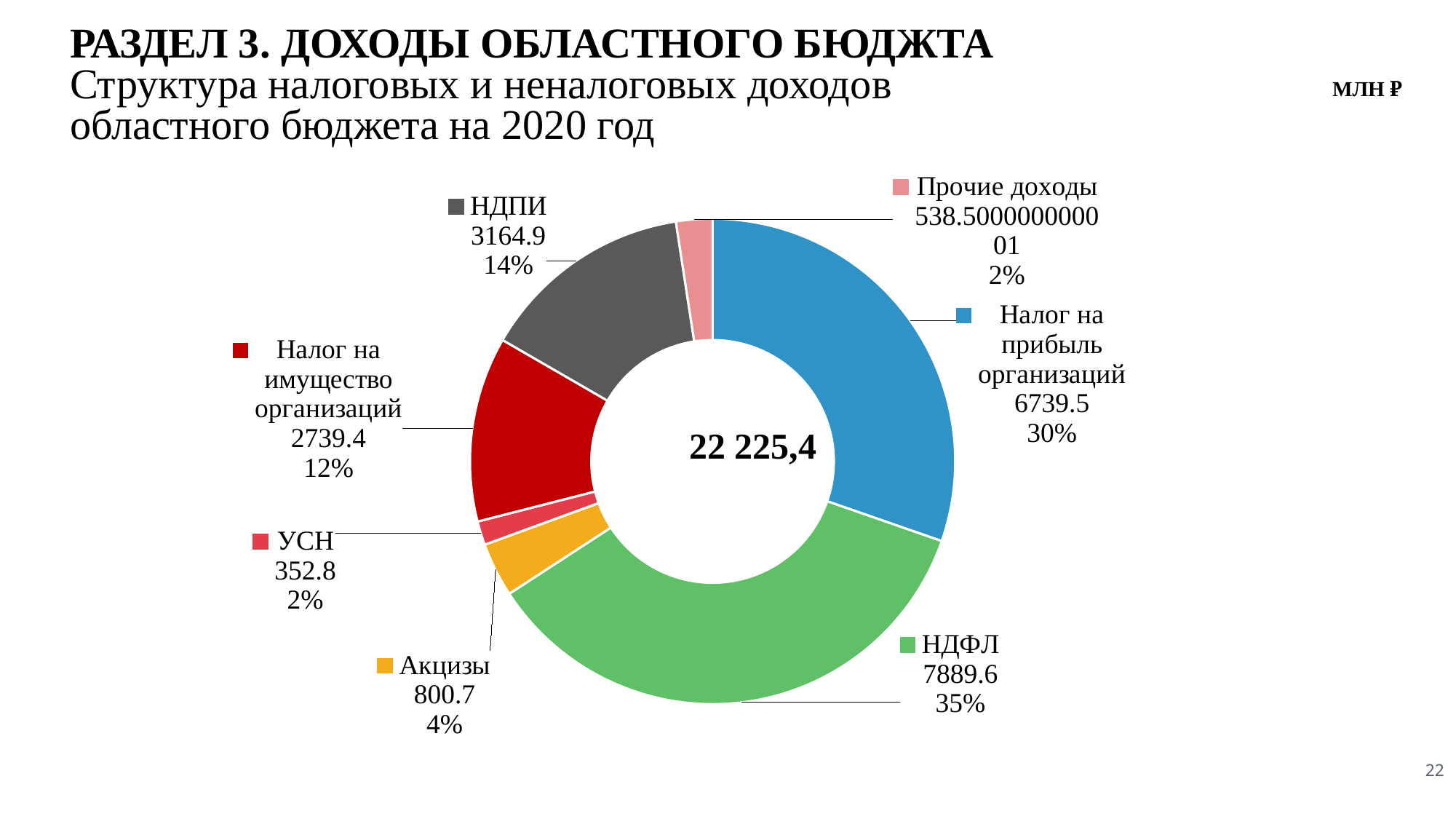
Which category has the largest share of the chart? НДФЛ What share of the total does Налог на имущество организаций represent? 12% What share of the total does НДПИ represent? 14% Which is larger, the value for НДПИ or the value for Налог на имущество организаций? НДПИ What is the difference between the values for НДФЛ and Налог на прибыль организаций? 1150.1 What total value is shown in the centre of the chart? 22 225,4 What is the value for НДФЛ? 7889.6 What is the value for Налог на прибыль организаций? 6739.5 Which category has the smallest value? УСН What type of chart is shown on the slide? Doughnut (pie) chart How many categories does the chart show? 7 What is the value for Акцизы? 800.7